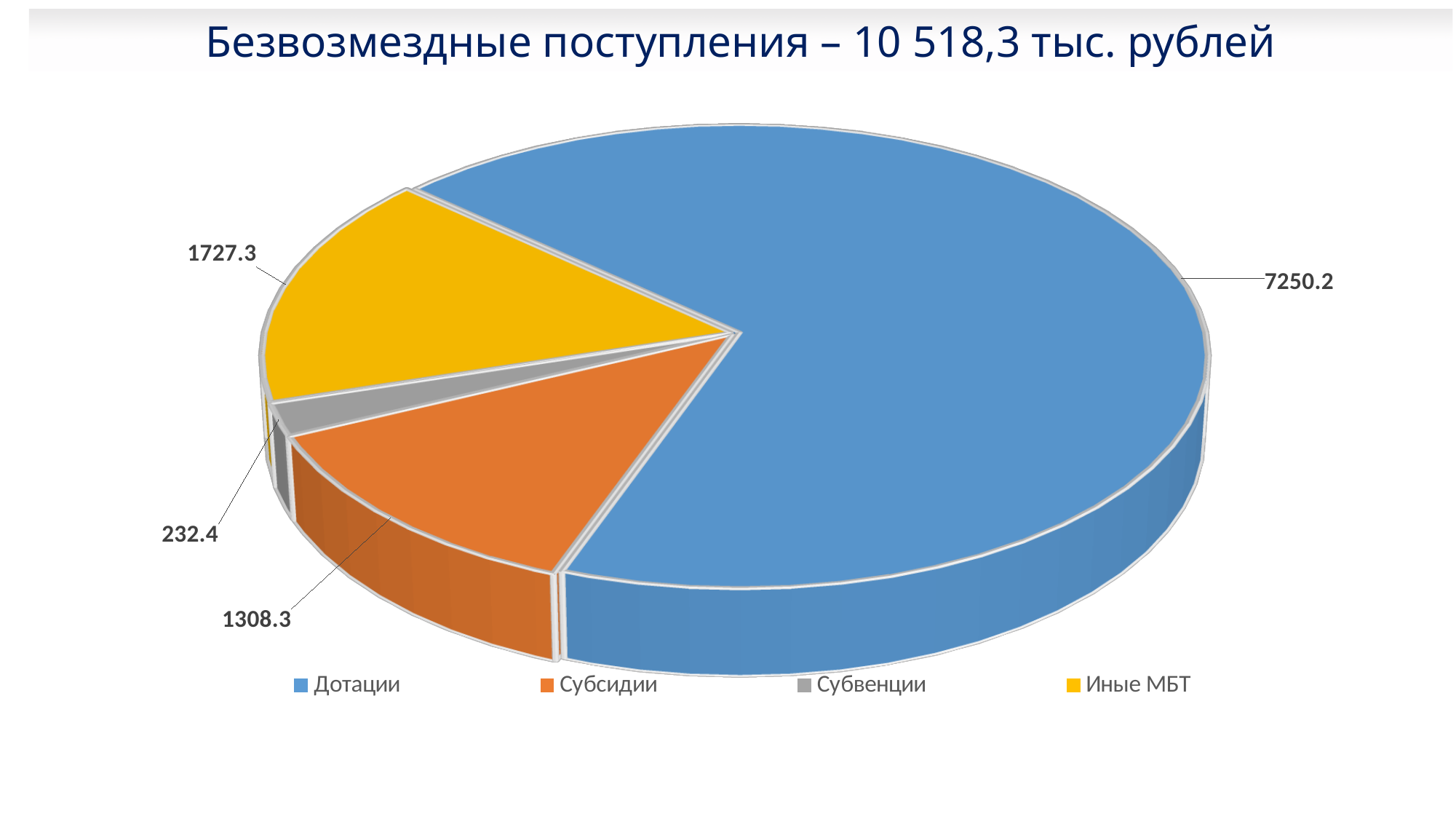
What is the value for Субсидии? 1308.3 What type of chart is shown on the slide? pie chart How many categories does the legend list? 4 What is the difference between the values for Дотации and Иные МБТ? 5522.9 What is the title of the chart? Безвозмездные поступления – 10 518,3 тыс. рублей What is the value for Субвенции? 232.4 What is the value for Иные МБТ? 1727.3 Which category has the largest slice of the pie? Дотации What is the difference between the values for Иные МБТ and Субсидии? 419.0 Which category has the smallest slice of the pie? Субвенции Which is larger, the value for Субсидии or the value for Иные МБТ? Иные МБТ What is the value for Дотации? 7250.2